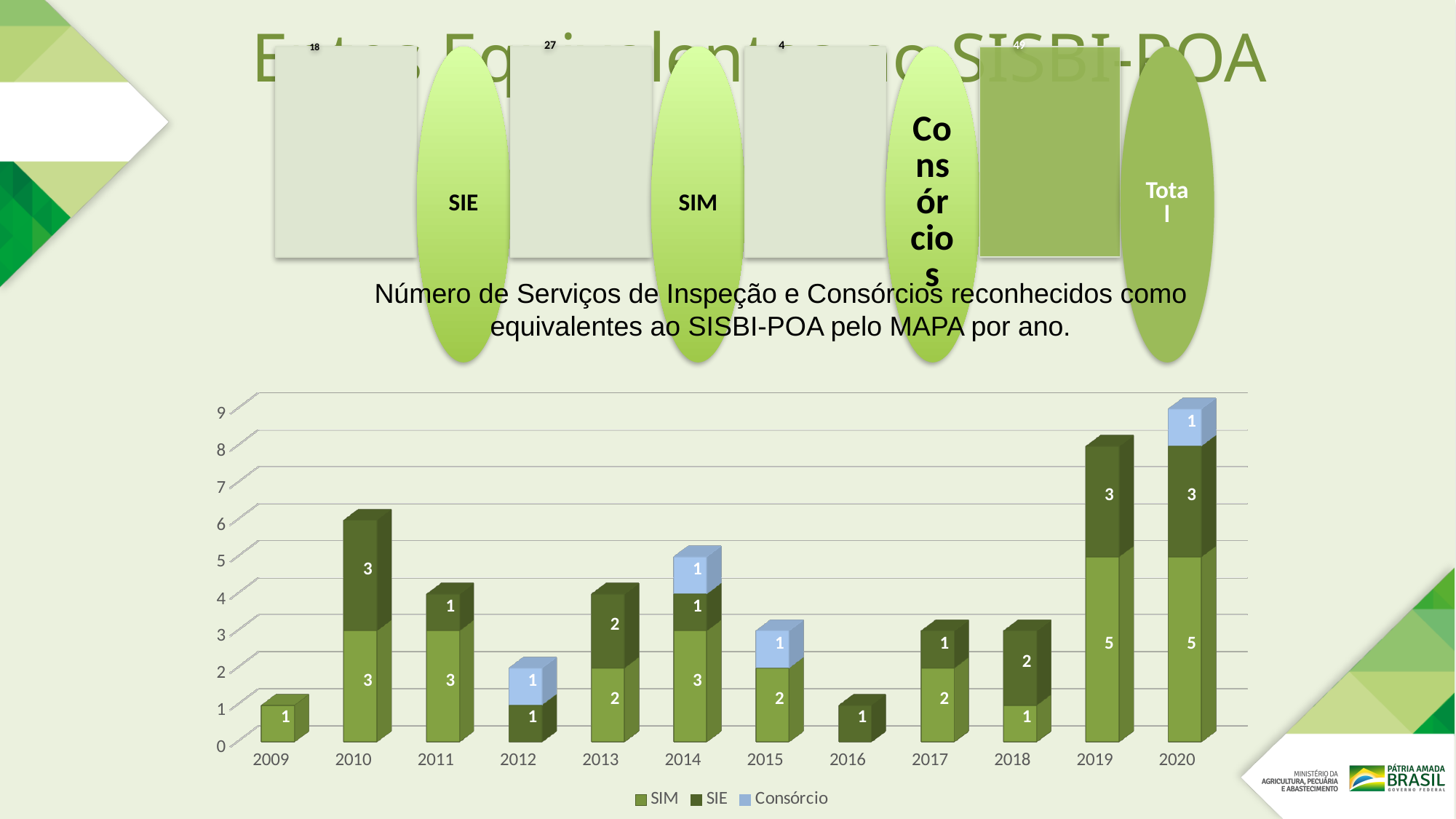
What is the SIM value for 2019? 5 Which year has the highest total stacked bar? 2020 Which is larger, the SIE value for 2010 or the SIE value for 2011? SIE value for 2010 What is the total of the stacked bar for 2010? 6 What is the SIE value for 2018? 2 What is the total of the stacked bar for 2020? 9 What is the difference between the SIM value for 2019 and the SIM value for 2017? 3 How many series does the chart legend list? 3 What type of chart is shown on the slide? stacked bar chart Which series is shown in light blue in the chart legend? Consórcio What is the Consórcio value for 2014? 1 How many years are shown on the x axis of the chart? 12